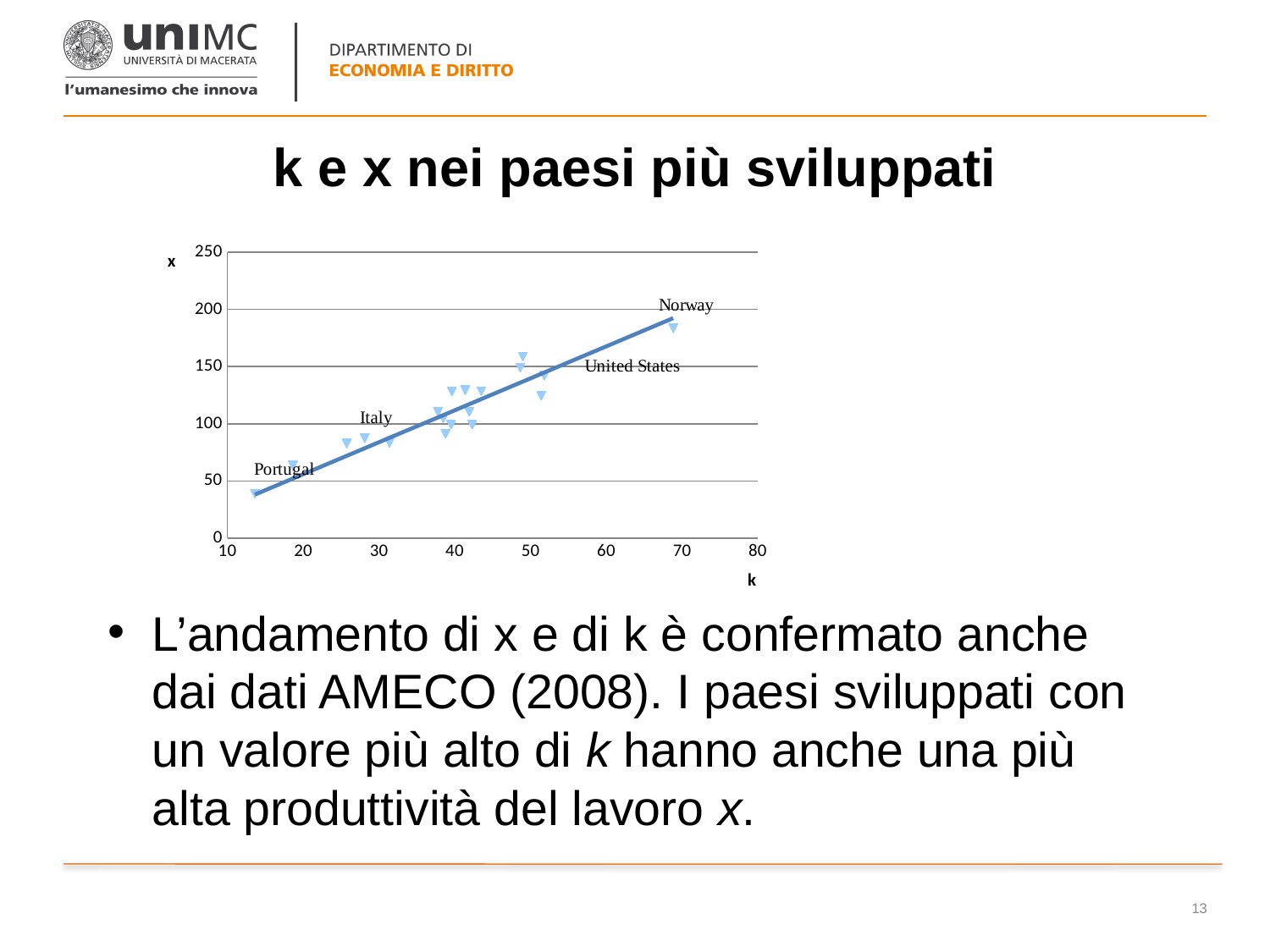
Which has a higher x value, Italy or Portugal? Italy As k increases along the horizontal axis, do the x values generally rise or fall? rise What is the title of the chart? k e x nei paesi più sviluppati What kind of chart is shown on the slide? scatter plot What label is shown on the vertical axis of the chart? x Which labelled country has the lowest x value in the chart? Portugal Is the x value for Norway greater or less than 150? greater Which labelled country has the highest x value in the chart? Norway Is the k value for Norway greater or less than 60? greater Is the x value for Norway greater or less than 200? less